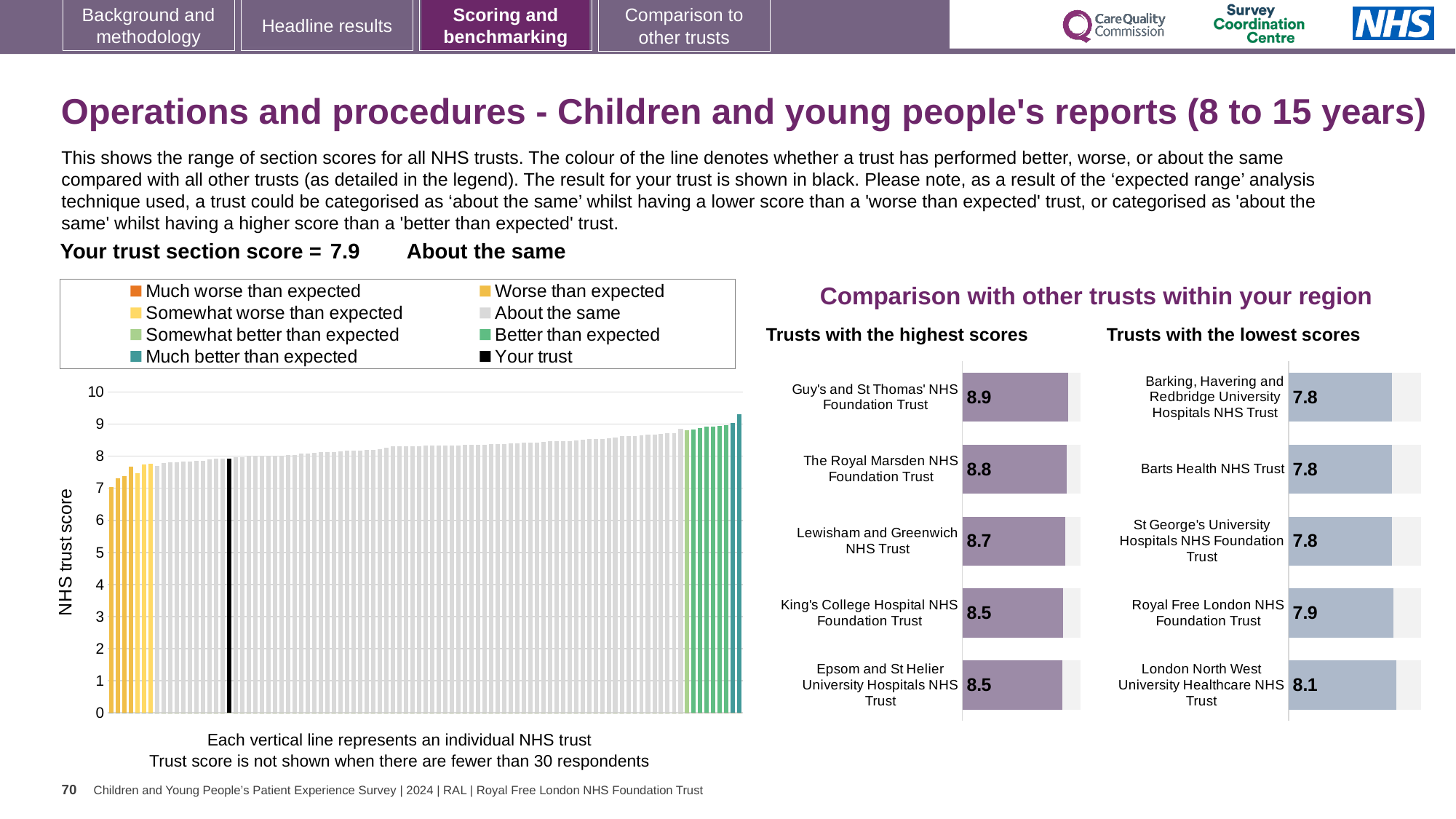
In the 'Trusts with the highest scores' chart, what is the difference between the scores of Guy's and St Thomas' NHS Foundation Trust and Lewisham and Greenwich NHS Trust? 0.2 In the 'Trusts with the lowest scores' chart, which is larger: the score for Royal Free London NHS Foundation Trust or London North West University Healthcare NHS Trust? London North West University Healthcare NHS Trust In the 'Trusts with the lowest scores' chart, what is the score for Royal Free London NHS Foundation Trust? 7.9 In the 'Trusts with the highest scores' chart, which trust has the highest score? Guy's and St Thomas' NHS Foundation Trust In the 'Trusts with the highest scores' chart, how many trusts are shown? 5 What kind of chart is the large chart on the left with the 'NHS trust score' axis? Bar chart In the 'Trusts with the highest scores' chart, what is the score for Lewisham and Greenwich NHS Trust? 8.7 In the large 'NHS trust score' chart on the left, do the bar values rise or fall from left to right? Rise In the 'Trusts with the lowest scores' chart, what is the difference between the scores of London North West University Healthcare NHS Trust and Barts Health NHS Trust? 0.3 How many entries does the legend above the 'NHS trust score' chart list? 8 In the 'Trusts with the highest scores' chart, what is the score for Guy's and St Thomas' NHS Foundation Trust? 8.9 In the 'Trusts with the lowest scores' chart, what is the score for London North West University Healthcare NHS Trust? 8.1